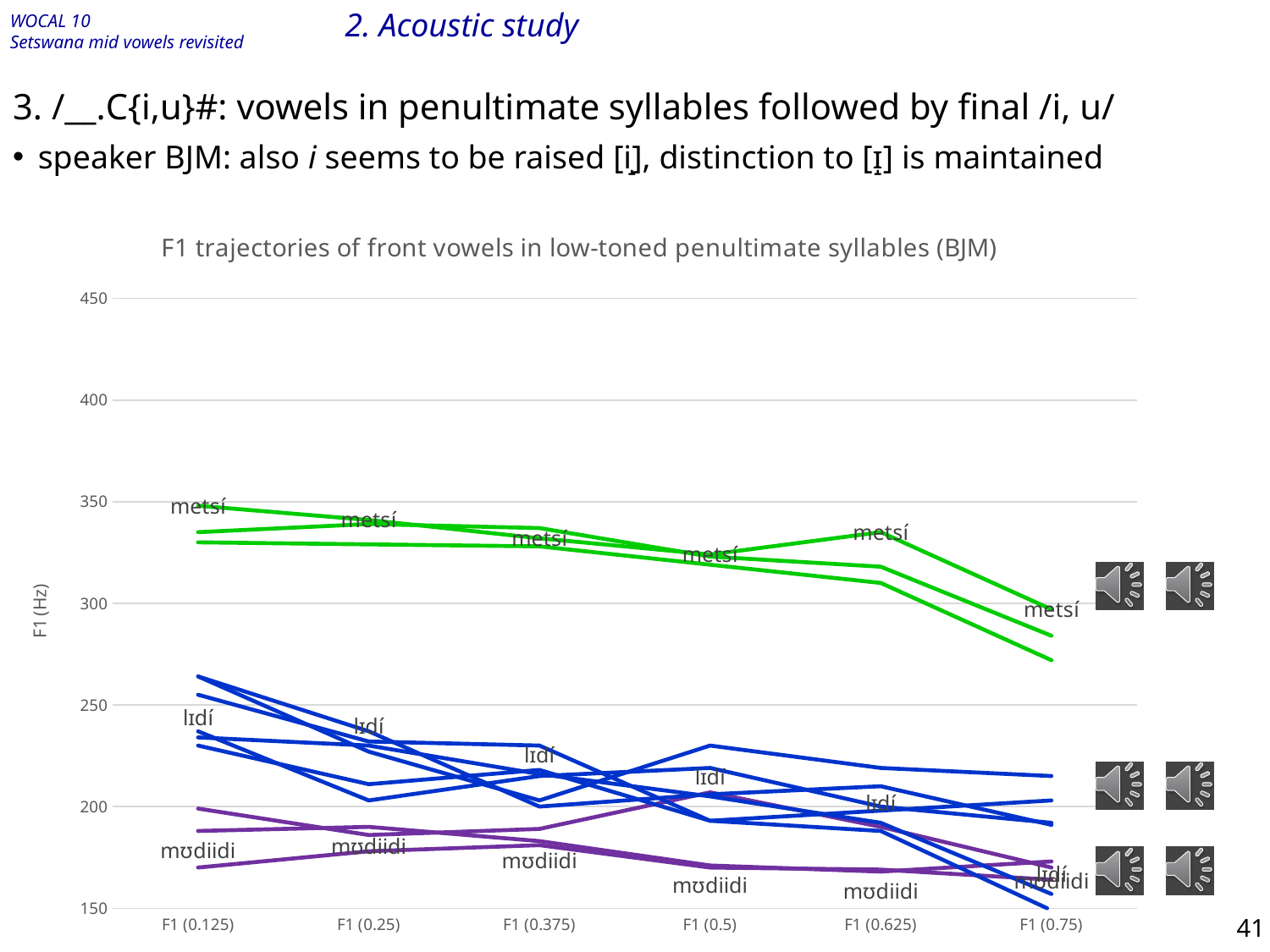
Are the lɪdí values at F1 (0.125) greater or less than 200? greater What kind of chart is shown on the slide? line chart Which word has the lowest F1 values at F1 (0.125)? mʊdiidi Do the metsí lines rise or fall from F1 (0.125) to F1 (0.75)? fall Are the mʊdiidi values at F1 (0.75) greater or less than 200? less Are the metsí values at F1 (0.75) greater or less than 350? less What is the label of the vertical axis? F1 (Hz) Which word has the highest F1 values across the chart? metsí How many time points are shown along the x axis? 6 At F1 (0.5), which word has the higher F1: metsí or lɪdí? metsí What is the title of the chart? F1 trajectories of front vowels in low-toned penultimate syllables (BJM)